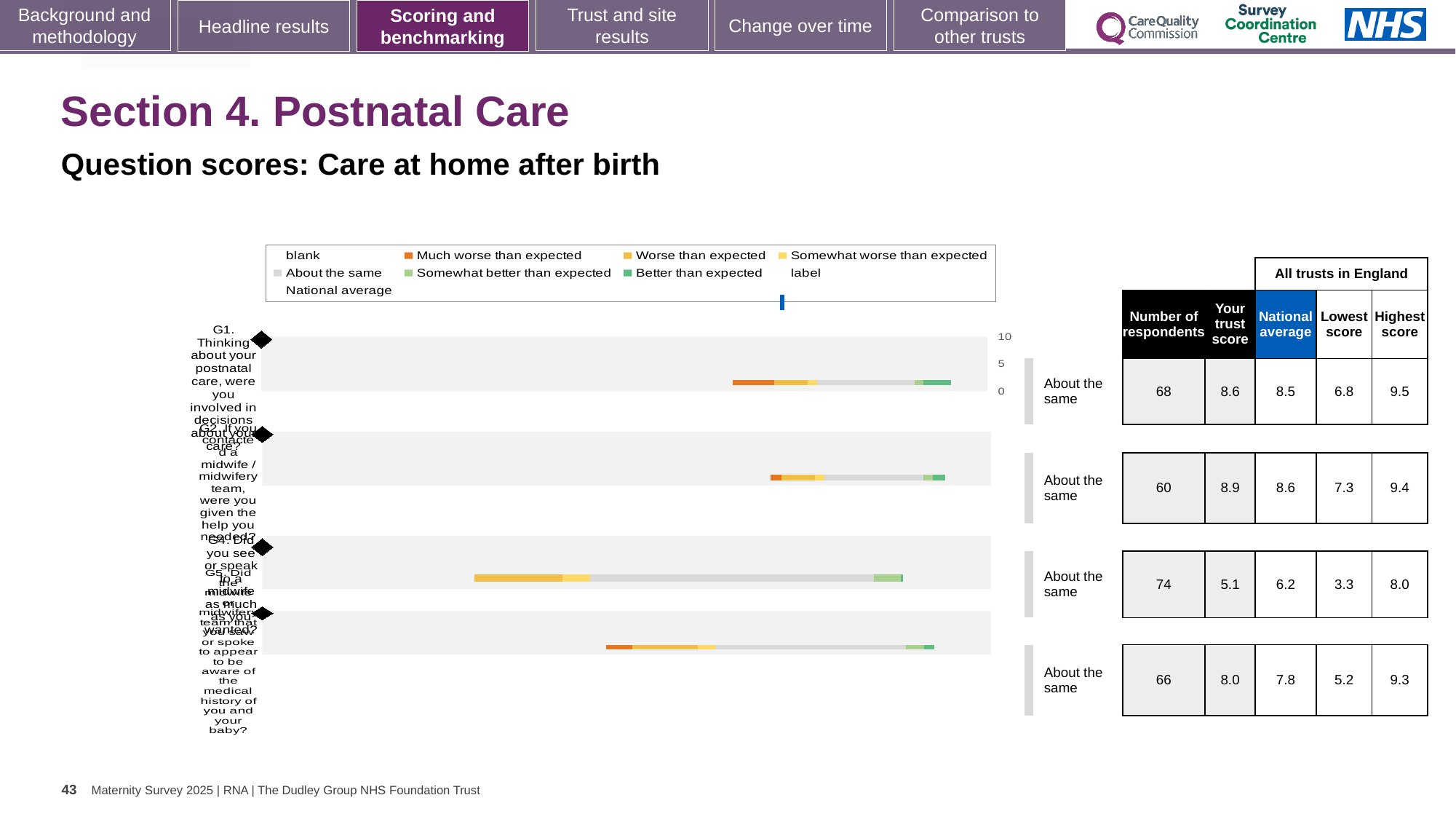
Which question has the lowest trust score in the table? G4 How many question bars are plotted in the chart? 4 What is the highest score across all trusts in England for question G1? 9.5 Which question has the highest trust score in the table? G2 For question G5, which is larger: the trust score or the national average? the trust score What is the national average for question G4 in the table beside the chart? 6.2 What is the difference between the highest score and the lowest score for question G4? 4.7 What kind of chart is shown on the slide? bar chart Which question has the highest number of respondents? G4 How many respondents answered question G2? 60 What benchmark category is shown for question G1? About the same What is the trust score for question G1 in the table beside the chart? 8.6